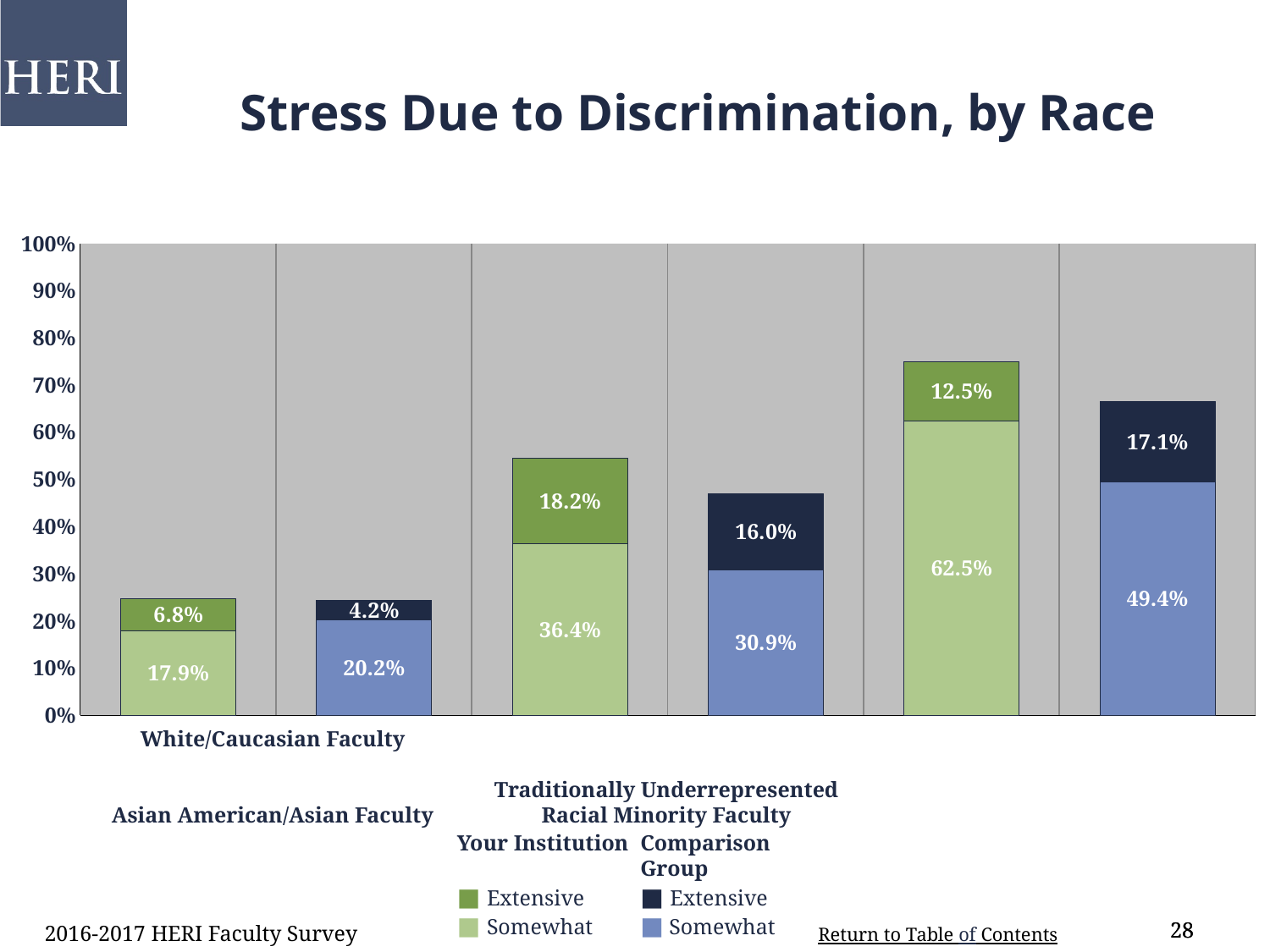
What percentage of White/Caucasian Faculty at Your Institution reported 'Somewhat' stress due to discrimination? 17.9% Which is larger: the 'Extensive' value for Asian American/Asian Faculty at Your Institution or in the Comparison Group? Your Institution What is the 'Somewhat' value for Traditionally Underrepresented Racial Minority Faculty at Your Institution? 62.5% What type of chart is shown on the slide? Stacked bar chart What is the difference between the 'Somewhat' values for Traditionally Underrepresented Racial Minority Faculty at Your Institution and in the Comparison Group? 13.1% What is the 'Extensive' value for Asian American/Asian Faculty in the Comparison Group? 16.0% Which race category has the lowest 'Extensive' value for the Comparison Group? White/Caucasian Faculty How many entries does the legend list? 4 What is the 'Extensive' value for White/Caucasian Faculty in the Comparison Group? 4.2% What is the total of the Comparison Group stacked bar for Traditionally Underrepresented Racial Minority Faculty? 66.5% Which race category has the highest 'Somewhat' value for Your Institution? Traditionally Underrepresented Racial Minority Faculty What is the total of the Your Institution stacked bar for Asian American/Asian Faculty? 54.6%